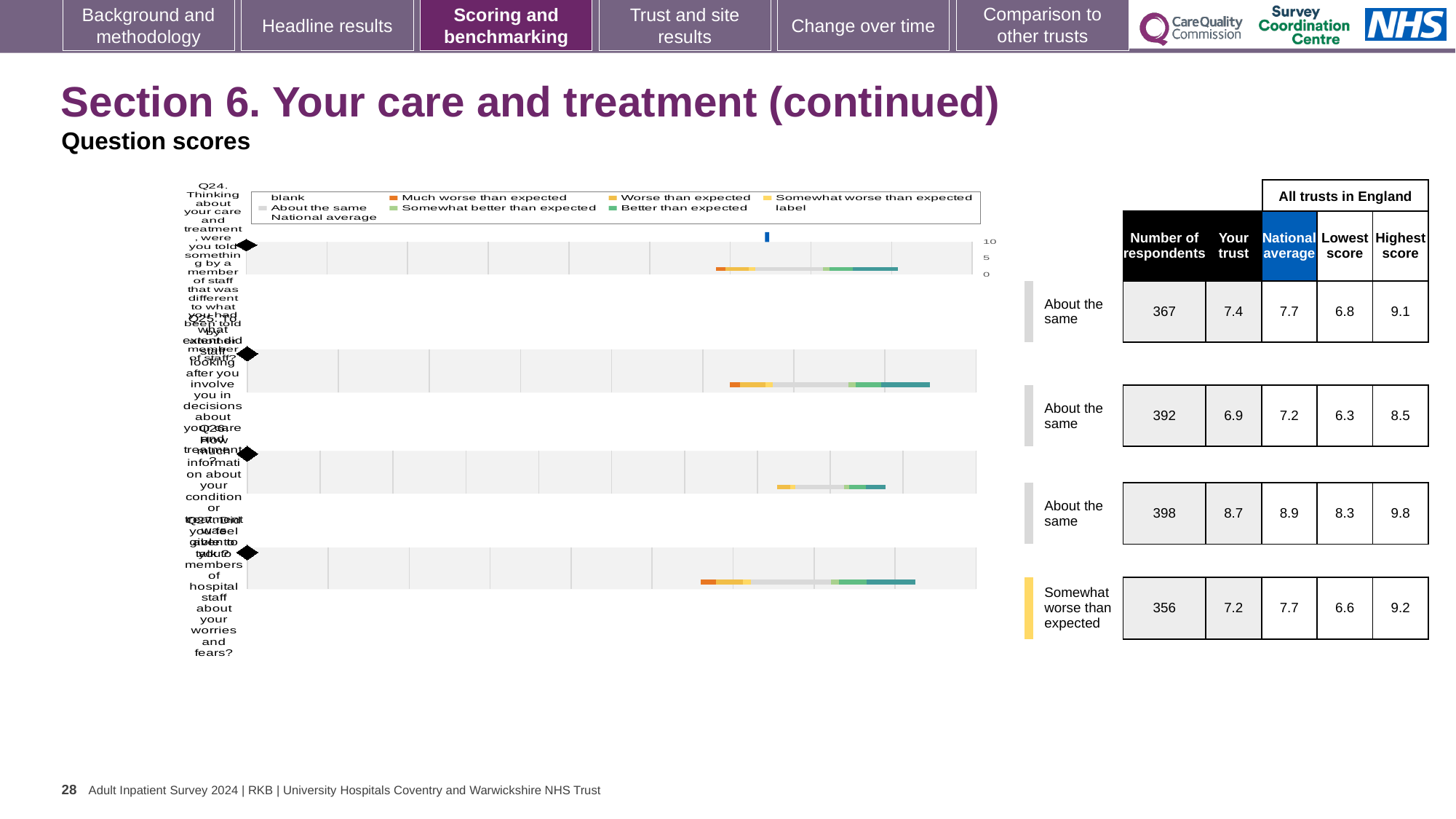
What is the lowest score among all trusts in England for Q24? 6.8 What is the national average score for Q25 (staff involving you in decisions about your care and treatment)? 7.2 What is the difference between the national average and the 'Your trust' score for Q24? 0.3 What is the highest score among all trusts in England for Q26 (how much information about your condition or treatment was given to you)? 9.8 What type of chart is used to show the question scores on this slide? bar chart Which question has the highest 'Your trust' score? Q26 What is the 'Your trust' score for Q24 (were you told something different by another member of staff)? 7.4 How many questions (Q24 to Q27) are plotted on the slide? 4 For Q25, which is larger: the 'Your trust' score or the national average? National average How many respondents answered Q27 (feeling able to talk to hospital staff about worries and fears)? 356 Which question has the fewest respondents? Q27 Which benchmark category is shown for Q27? Somewhat worse than expected